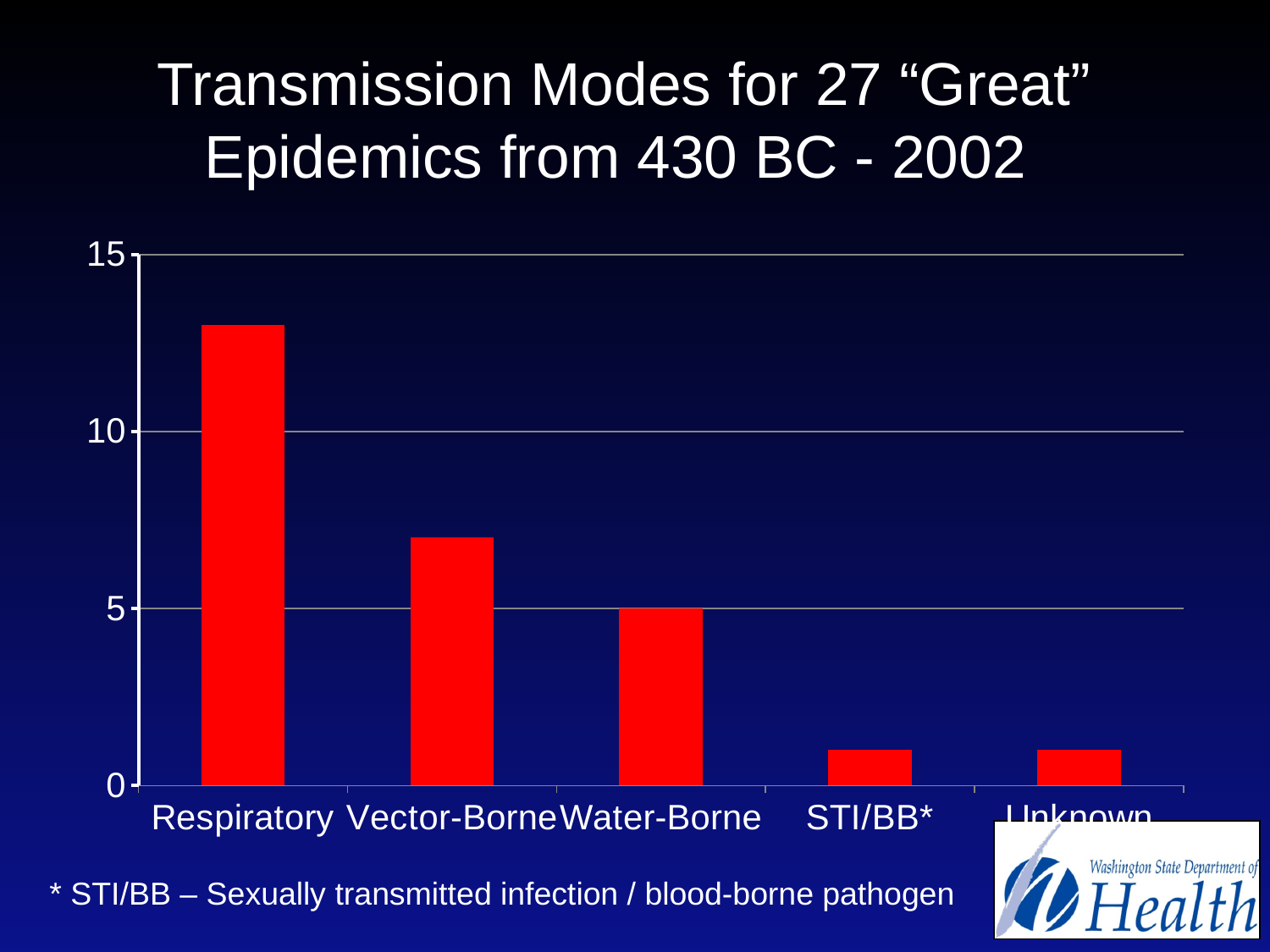
What colour are the bars in the chart? red How many transmission mode categories are shown on the x axis? 5 Which is larger, the value for Respiratory or the value for Vector-Borne? Respiratory What is the value for Water-Borne? 5 Is the value for STI/BB* greater or less than 5? less Is the value for Vector-Borne greater or less than 5? greater Which transmission mode has the highest number of epidemics? Respiratory Which is larger, the value for Vector-Borne or the value for Water-Borne? Vector-Borne Do the bar values rise or fall from left to right along the x axis? fall Is the value for Vector-Borne greater or less than 10? less What kind of chart is shown on the slide? bar chart